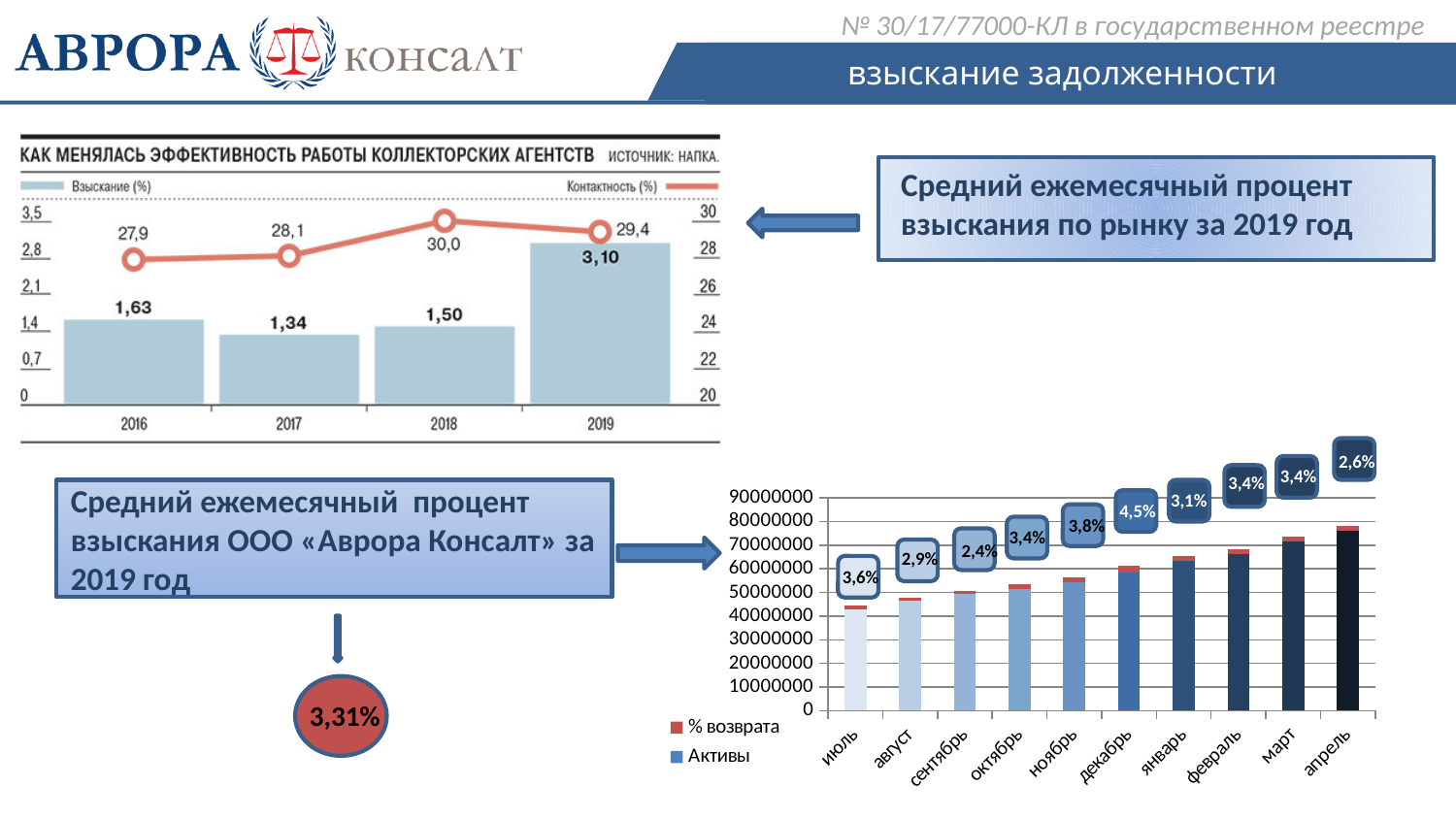
In the top-left chart 'Как менялась эффективность работы коллекторских агентств', is the Контактность (%) value for 2016 larger or smaller than for 2017? smaller In the top-left chart 'Как менялась эффективность работы коллекторских агентств', how many years are shown on the x axis? 4 In the top-left chart 'Как менялась эффективность работы коллекторских агентств', what is the Взыскание (%) value for 2019? 3,10 In the bottom-right chart, which month has the lowest % возврата label? сентябрь In the top-left chart 'Как менялась эффективность работы коллекторских агентств', which year has the lowest Взыскание (%) value? 2017 In the top-left chart 'Как менялась эффективность работы коллекторских агентств', which year has the highest Взыскание (%) value? 2019 In the top-left chart 'Как менялась эффективность работы коллекторских агентств', what is the Контактность (%) value for 2018? 30,0 In the top-left chart 'Как менялась эффективность работы коллекторских агентств', what is the difference between the Взыскание (%) values for 2019 and 2018? 1,60 In the bottom-right chart, how many series does the legend list? 2 In the bottom-right chart, how many months are shown on the x axis? 10 In the bottom-right chart, is the Активы bar for июль greater or less than 50000000? less In the bottom-right chart, what is the % возврата label for декабрь? 4,5%